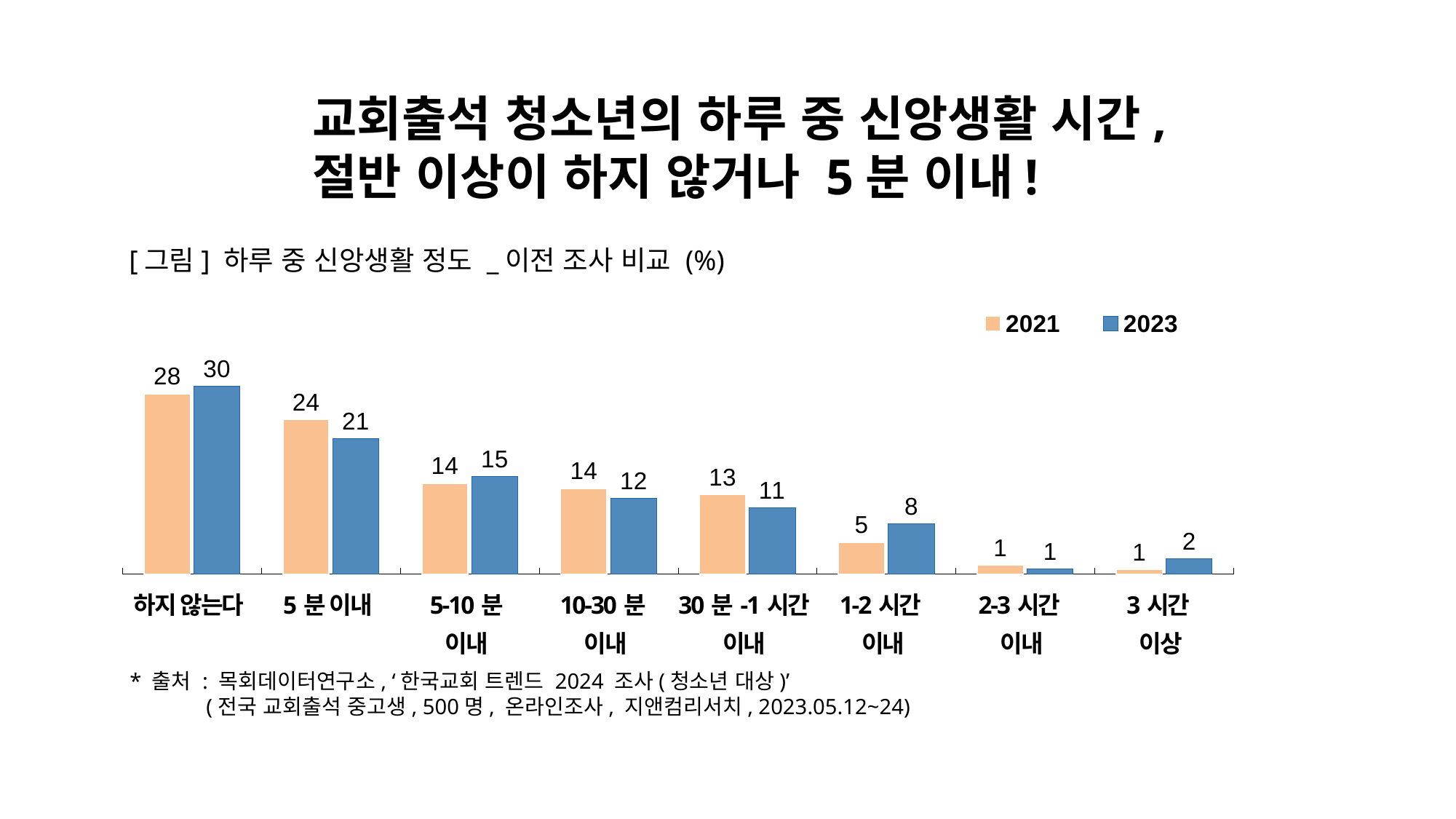
How many series does the legend list? 2 For 30 분 -1 시간 이내, which year has the larger value, 2021 or 2023? 2021 What kind of chart is shown on the slide? Bar chart Do the 2023 values generally rise or fall from left to right along the x axis? Fall What is the difference between the 2021 and 2023 values for 5 분 이내? 3 What is the 2021 value for 5 분 이내? 24 Which series is shown in blue in the legend? 2023 How many categories are shown on the x axis? 8 What is the 2023 value for 하지 않는다? 30 Which category has the highest 2023 value? 하지 않는다 Which category has the lowest 2021 value? 3 시간 이상 What is the 2023 value for 1-2 시간 이내? 8